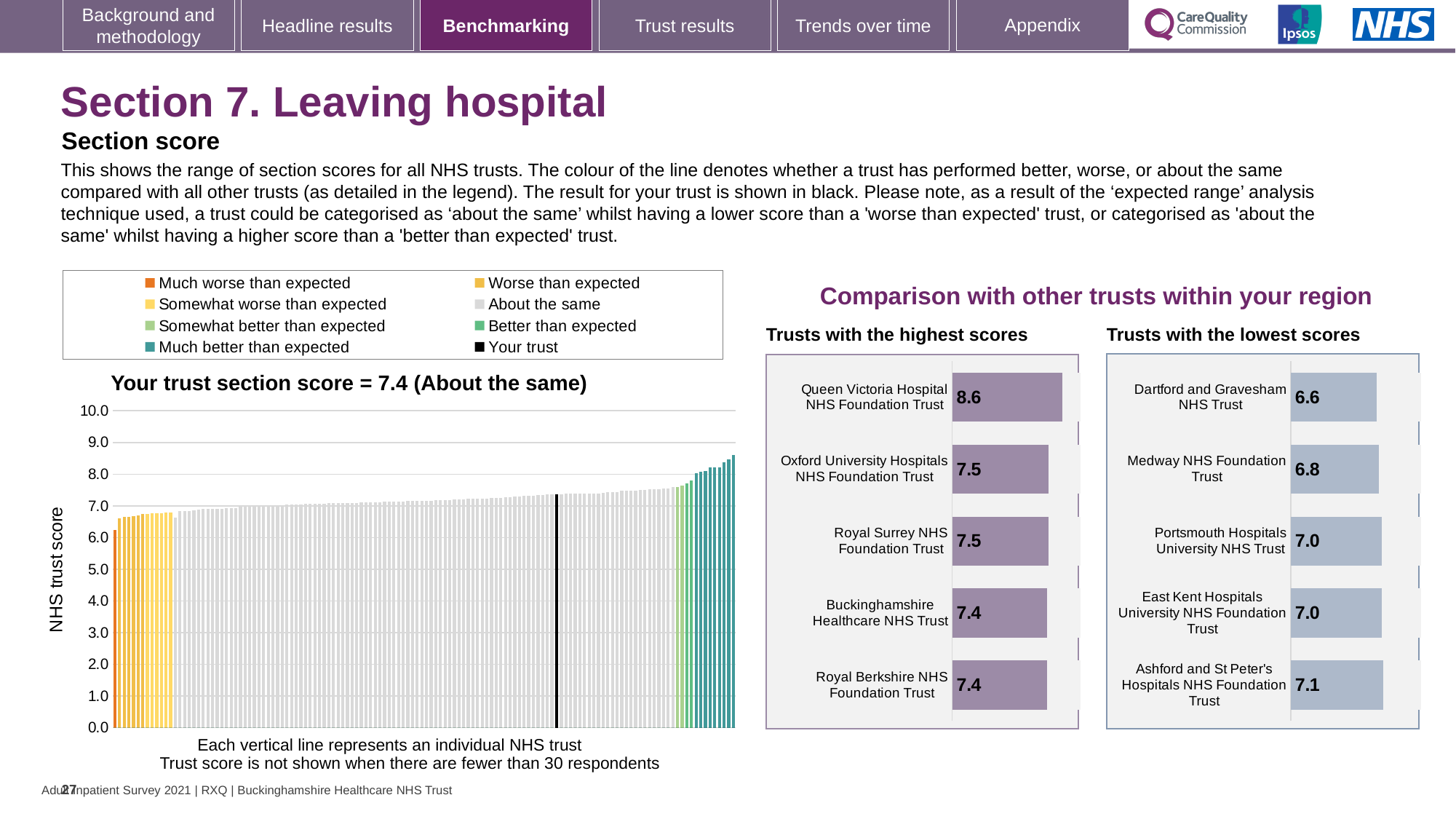
In the 'Trusts with the highest scores' chart, which trust has the highest score? Queen Victoria Hospital NHS Foundation Trust In the 'Trusts with the highest scores' chart, what is the score for Royal Berkshire NHS Foundation Trust? 7.4 How many trusts are listed in the 'Trusts with the lowest scores' chart? 5 How many entries does the legend of the main chart on the left list? 8 In the 'Trusts with the lowest scores' chart, which trust has the lowest score? Dartford and Gravesham NHS Trust In the main chart on the left, is the value of the leftmost (lowest) bar greater or less than 7.0? less In the 'Trusts with the lowest scores' chart, what is the score for Medway NHS Foundation Trust? 6.8 In the 'Trusts with the lowest scores' chart, what is the difference between the scores of Ashford and St Peter's Hospitals NHS Foundation Trust and Dartford and Gravesham NHS Trust? 0.5 According to the title of the main chart on the left, what is your trust's section score? 7.4 In the 'Trusts with the highest scores' chart, what is the score for Queen Victoria Hospital NHS Foundation Trust? 8.6 In the 'Trusts with the highest scores' chart, what is the difference between the scores of Queen Victoria Hospital NHS Foundation Trust and Buckinghamshire Healthcare NHS Trust? 1.2 In the 'Trusts with the lowest scores' chart, which has the higher score: Medway NHS Foundation Trust or Dartford and Gravesham NHS Trust? Medway NHS Foundation Trust